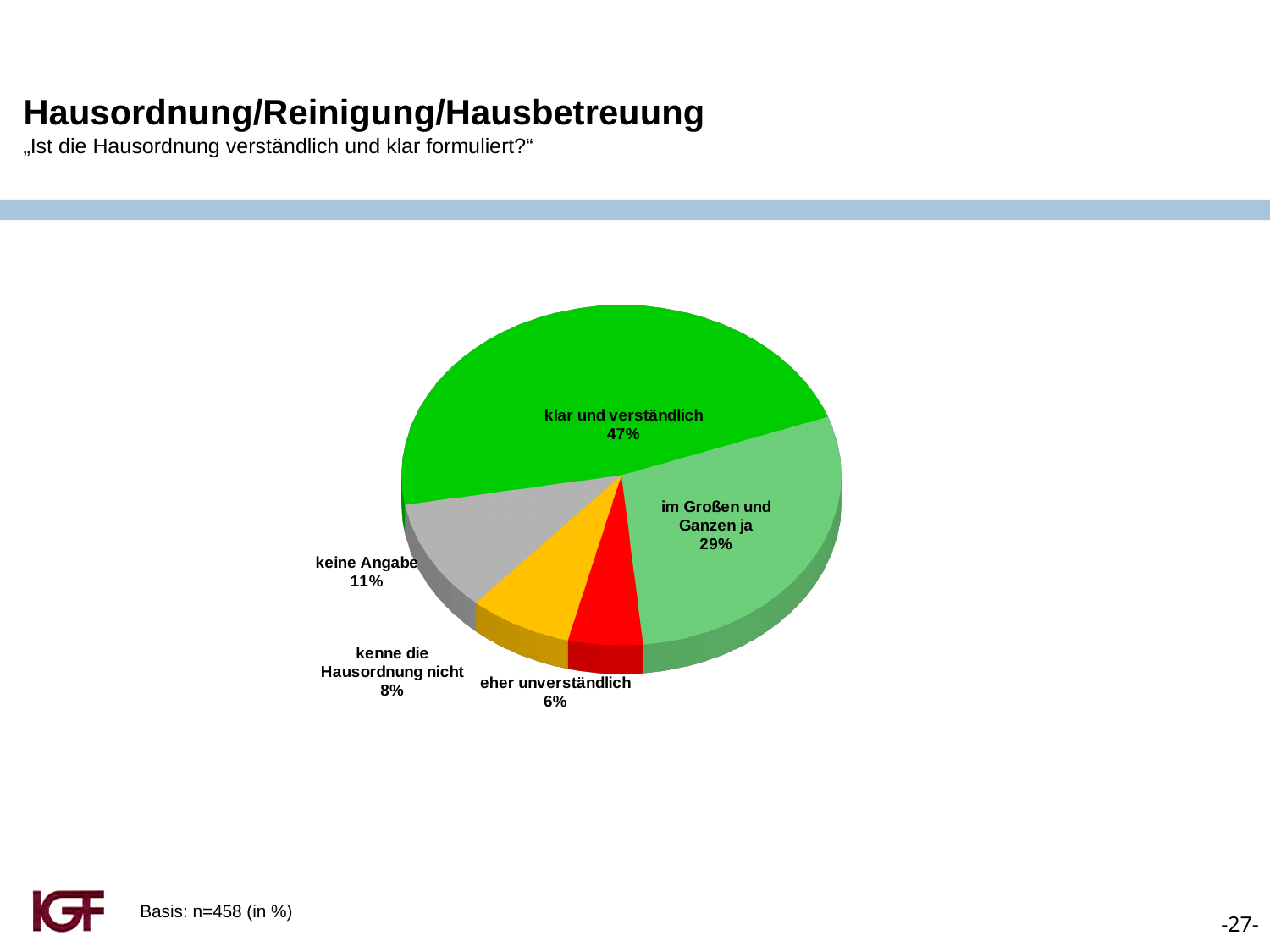
Which is larger, the share for "keine Angabe" or the share for "kenne die Hausordnung nicht"? keine Angabe What share of respondents answered "im Großen und Ganzen ja"? 29% Which answer category has the largest slice of the pie? klar und verständlich What share of respondents answered "kenne die Hausordnung nicht"? 8% What share of respondents answered "eher unverständlich"? 6% What colour is the slice for "eher unverständlich"? red What is the difference in percentage points between "klar und verständlich" and "im Großen und Ganzen ja"? 18 percentage points What kind of chart is shown on the slide? pie chart How many slices does the pie chart have? 5 What share of respondents answered "keine Angabe"? 11% What share of respondents answered "klar und verständlich"? 47% Which answer category has the smallest slice of the pie? eher unverständlich